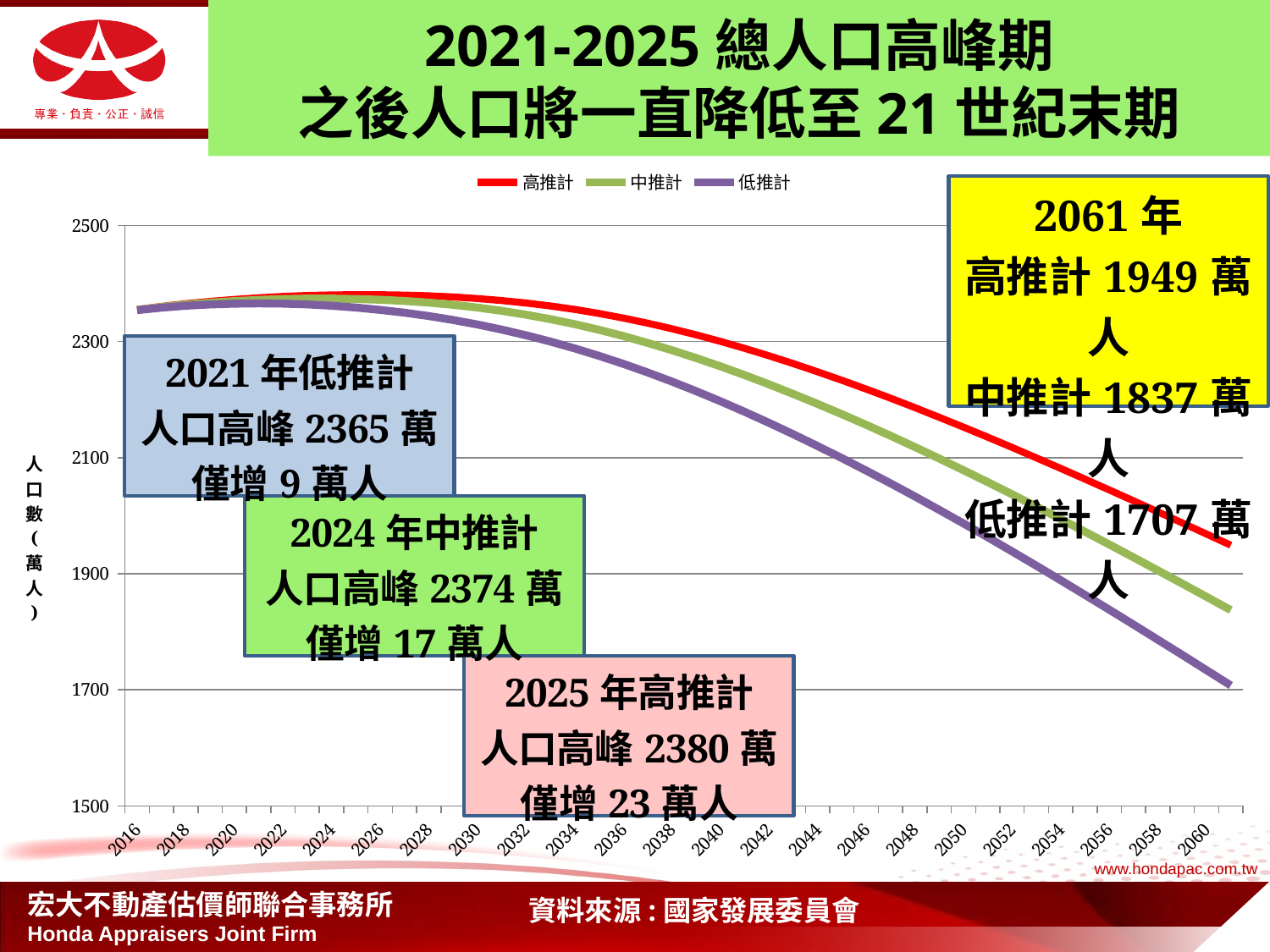
What is the 低推計 population value given for 2061? 1707 萬人 What is the 高推計 population value given for 2061? 1949 萬人 How many series does the legend list? 3 Is the 低推計 value at 2060 greater or less than 1900? less According to the annotation, what is the 2024 中推計 population peak? 2374 萬人 What is the difference between the 高推計 peak (2380 萬) and the 低推計 peak (2365 萬)? 15 萬人 Do the three series rise or fall along the x axis after about 2030? fall According to the annotation, what is the 2021 低推計 population peak? 2365 萬人 What is the difference between the 高推計 and 低推計 values given for 2061? 242 萬人 What kind of chart is shown on the slide? line chart Which series has the highest value at the right end of the chart (2060)? 高推計 According to the annotation, what is the 2025 高推計 population peak? 2380 萬人